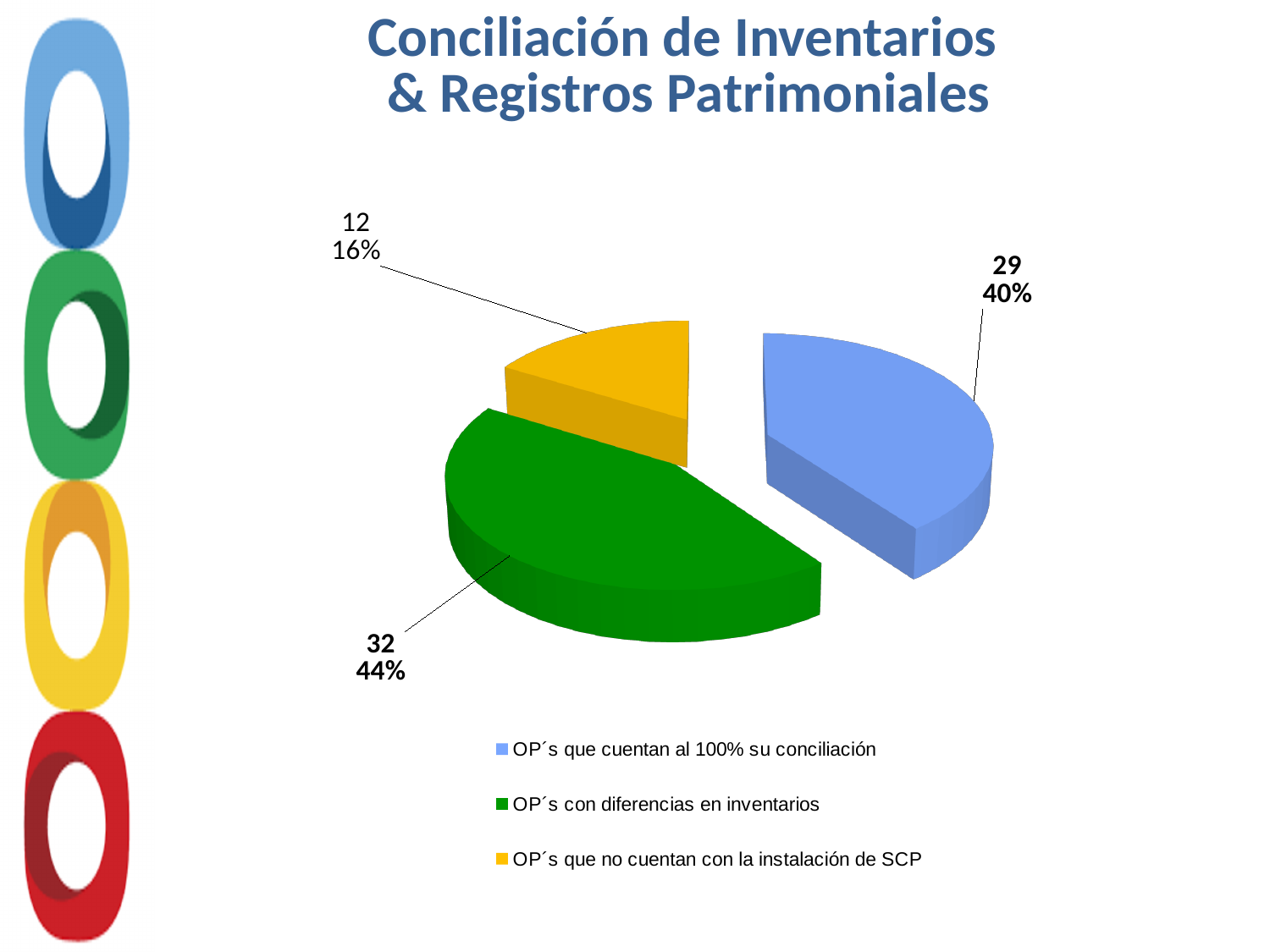
How many slices does the pie chart have? 3 What is the difference between the values for 'OP´s con diferencias en inventarios' and 'OP´s que no cuentan con la instalación de SCP'? 20 Which category has the largest slice? OP´s con diferencias en inventarios What kind of chart is shown on the slide? Pie chart What is the value for 'OP´s con diferencias en inventarios'? 32 What percentage share does 'OP´s que no cuentan con la instalación de SCP' have? 16% Which colour represents 'OP´s que cuentan al 100% su conciliación'? Blue What percentage share does 'OP´s con diferencias en inventarios' have? 44% How many entries does the legend list? 3 What is the value for 'OP´s que cuentan al 100% su conciliación'? 29 What is the value for 'OP´s que no cuentan con la instalación de SCP'? 12 Which category has the smallest slice? OP´s que no cuentan con la instalación de SCP